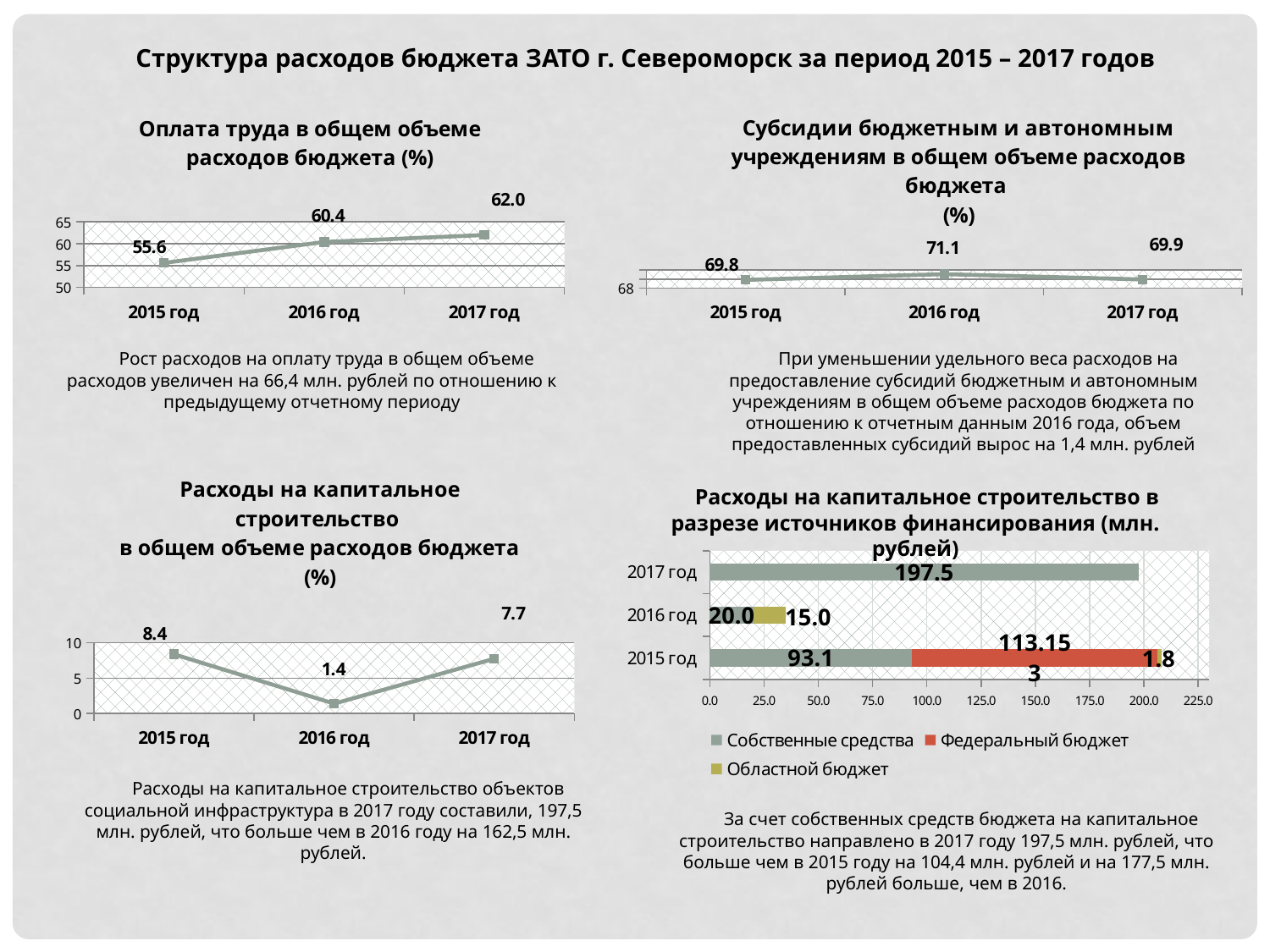
In the chart 'Расходы на капитальное строительство в общем объеме расходов бюджета (%)', which year has the lowest value? 2016 год In the chart 'Расходы на капитальное строительство в общем объеме расходов бюджета (%)', what is the difference between the 2015 год and 2016 год values? 7.0 In the chart 'Субсидии бюджетным и автономным учреждениям в общем объеме расходов бюджета (%)', what is the value for 2016 год? 71.1 How many series does the legend list in the chart 'Расходы на капитальное строительство в разрезе источников финансирования (млн. рублей)'? 3 In the chart 'Оплата труда в общем объеме расходов бюджета (%)', do the values rise or fall from 2015 to 2017? rise In the chart 'Оплата труда в общем объеме расходов бюджета (%)', what is the value for 2016 год? 60.4 In the chart 'Расходы на капитальное строительство в разрезе источников финансирования (млн. рублей)', what is the value of Собственные средства for 2017 год? 197.5 In the chart 'Расходы на капитальное строительство в разрезе источников финансирования (млн. рублей)', what is the total of the stacked bar for 2016 год? 35.0 In the chart 'Оплата труда в общем объеме расходов бюджета (%)', which year has the highest value? 2017 год In the chart 'Субсидии бюджетным и автономным учреждениям в общем объеме расходов бюджета (%)', which year has the highest value? 2016 год What kind of chart is 'Расходы на капитальное строительство в разрезе источников финансирования (млн. рублей)'? bar chart In the chart 'Оплата труда в общем объеме расходов бюджета (%)', what is the difference between the 2017 год and 2015 год values? 6.4